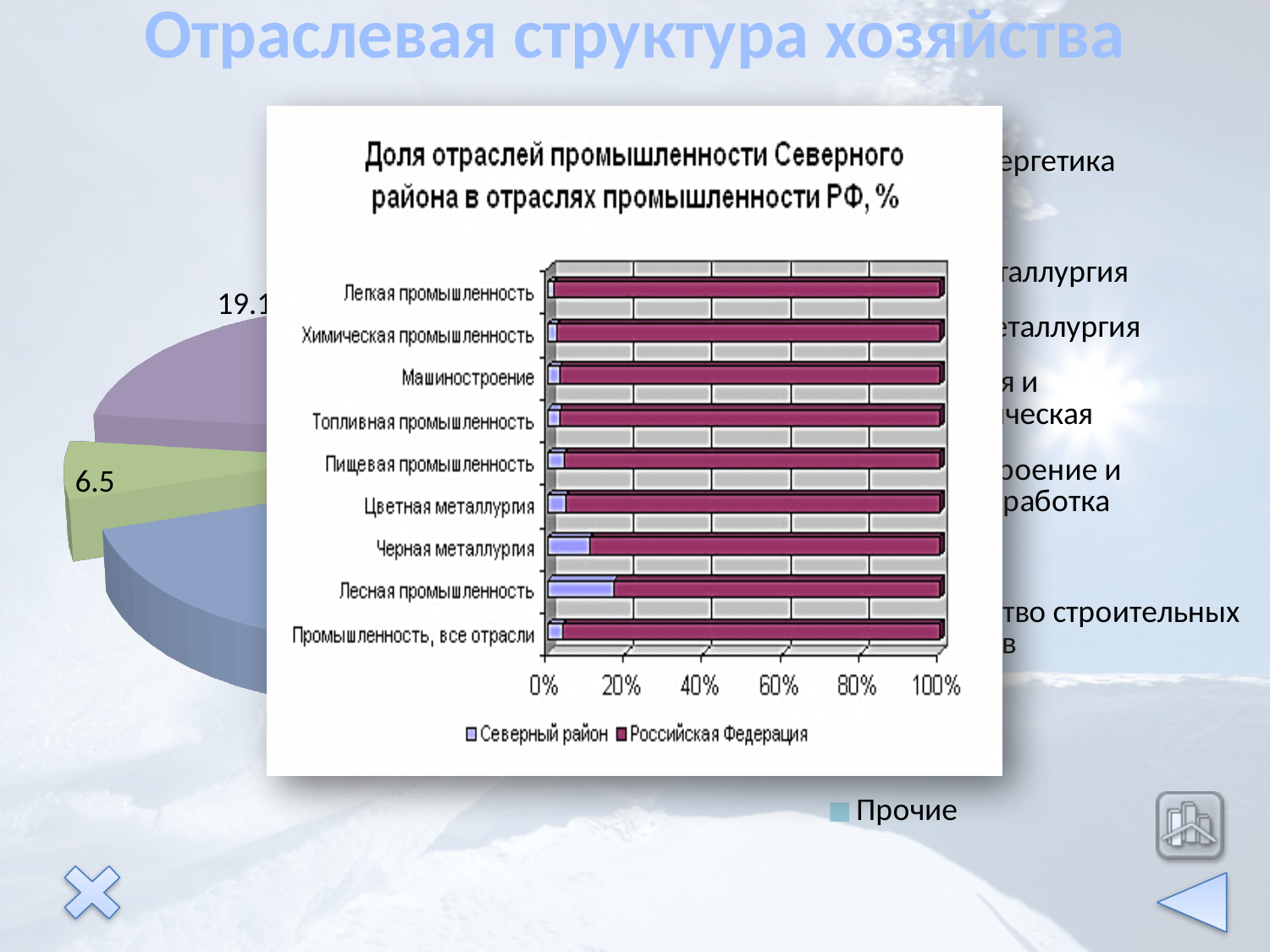
How many industry categories are listed on the y axis of the bar chart 'Доля отраслей промышленности Северного района в отраслях промышленности РФ, %'? 9 In the bar chart 'Доля отраслей промышленности Северного района в отраслях промышленности РФ, %', which has the larger Северный район value: Черная металлургия or Машиностроение? Черная металлургия In the bar chart 'Доля отраслей промышленности Северного района в отраслях промышленности РФ, %', is the Северный район value for Легкая промышленность greater or less than 20%? less In the bar chart 'Доля отраслей промышленности Северного района в отраслях промышленности РФ, %', what value do the Российская Федерация bars reach for every category? 100% What are the two legend entries of the bar chart 'Доля отраслей промышленности Северного района в отраслях промышленности РФ, %'? Северный район, Российская Федерация In the bar chart 'Доля отраслей промышленности Северного района в отраслях промышленности РФ, %', which category has the highest value for Северный район? Лесная промышленность How many series does the legend of the bar chart 'Доля отраслей промышленности Северного района в отраслях промышленности РФ, %' list? 2 What is the title of the bar chart shown in the centre of the slide? Доля отраслей промышленности Северного района в отраслях промышленности РФ, % What kind of chart is 'Доля отраслей промышленности Северного района в отраслях промышленности РФ, %'? bar chart In the bar chart 'Доля отраслей промышленности Северного района в отраслях промышленности РФ, %', which has the larger Северный район value: Лесная промышленность or Черная металлургия? Лесная промышленность In the bar chart 'Доля отраслей промышленности Северного района в отраслях промышленности РФ, %', is the Северный район value for Лесная промышленность greater or less than 20%? less In the bar chart 'Доля отраслей промышленности Северного района в отраслях промышленности РФ, %', is the Северный район value for Черная металлургия greater or less than 20%? less